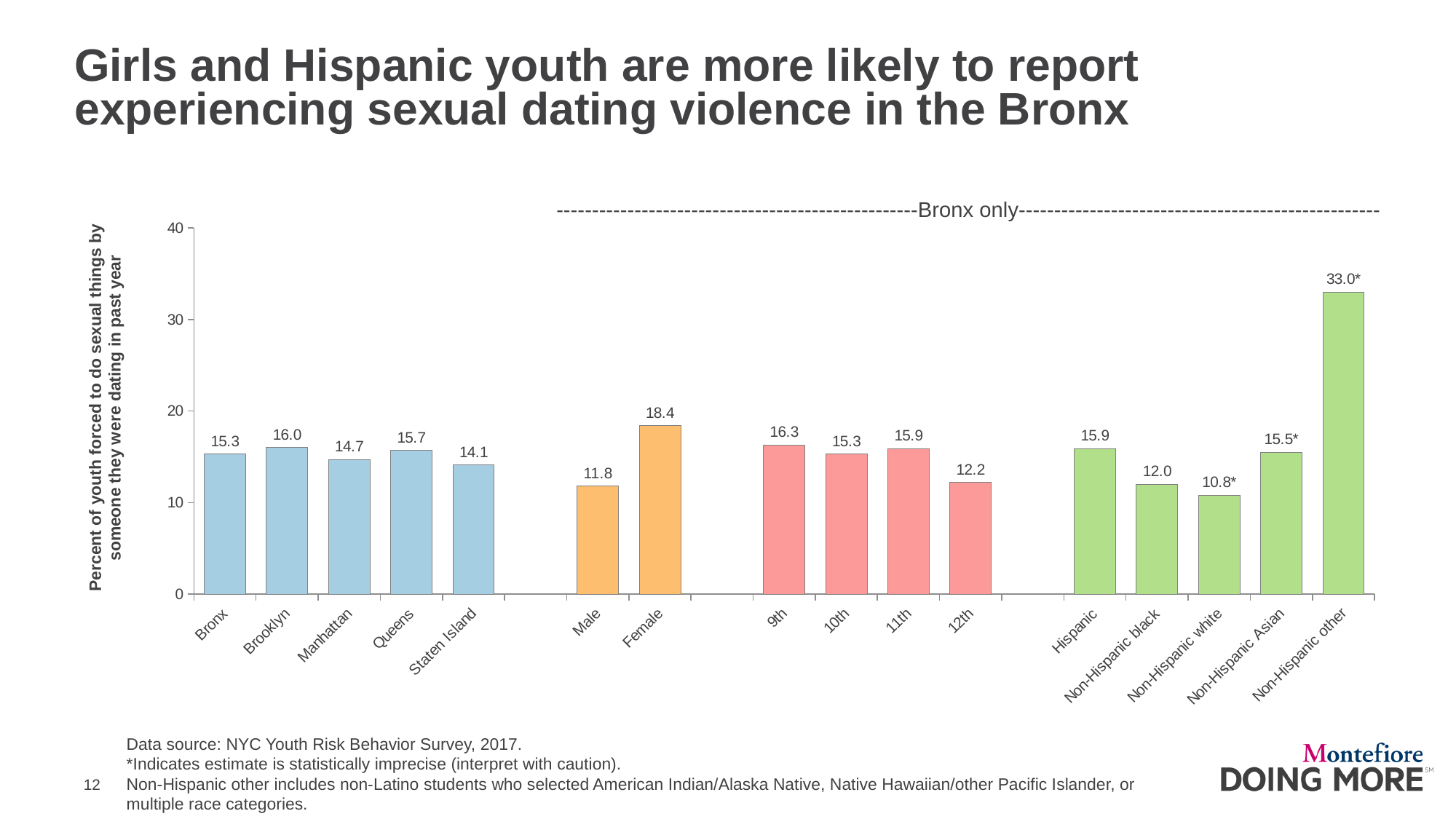
What is the value for Staten Island? 14.1 What is the y-axis label of the chart? Percent of youth forced to do sexual things by someone they were dating in past year Which category has the highest value on the chart? Non-Hispanic other Is the value for Non-Hispanic other greater or less than 30? greater What is the value for Non-Hispanic white? 10.8* Which borough has the lowest value? Staten Island What kind of chart is shown on the slide? Bar chart How many bars are plotted on the chart? 16 Which is larger, the value for 9th grade or 12th grade? 9th Do the values fall or rise from 9th grade to 12th grade? Fall What is the value for Female? 18.4 What is the difference between the Female and Male values? 6.6